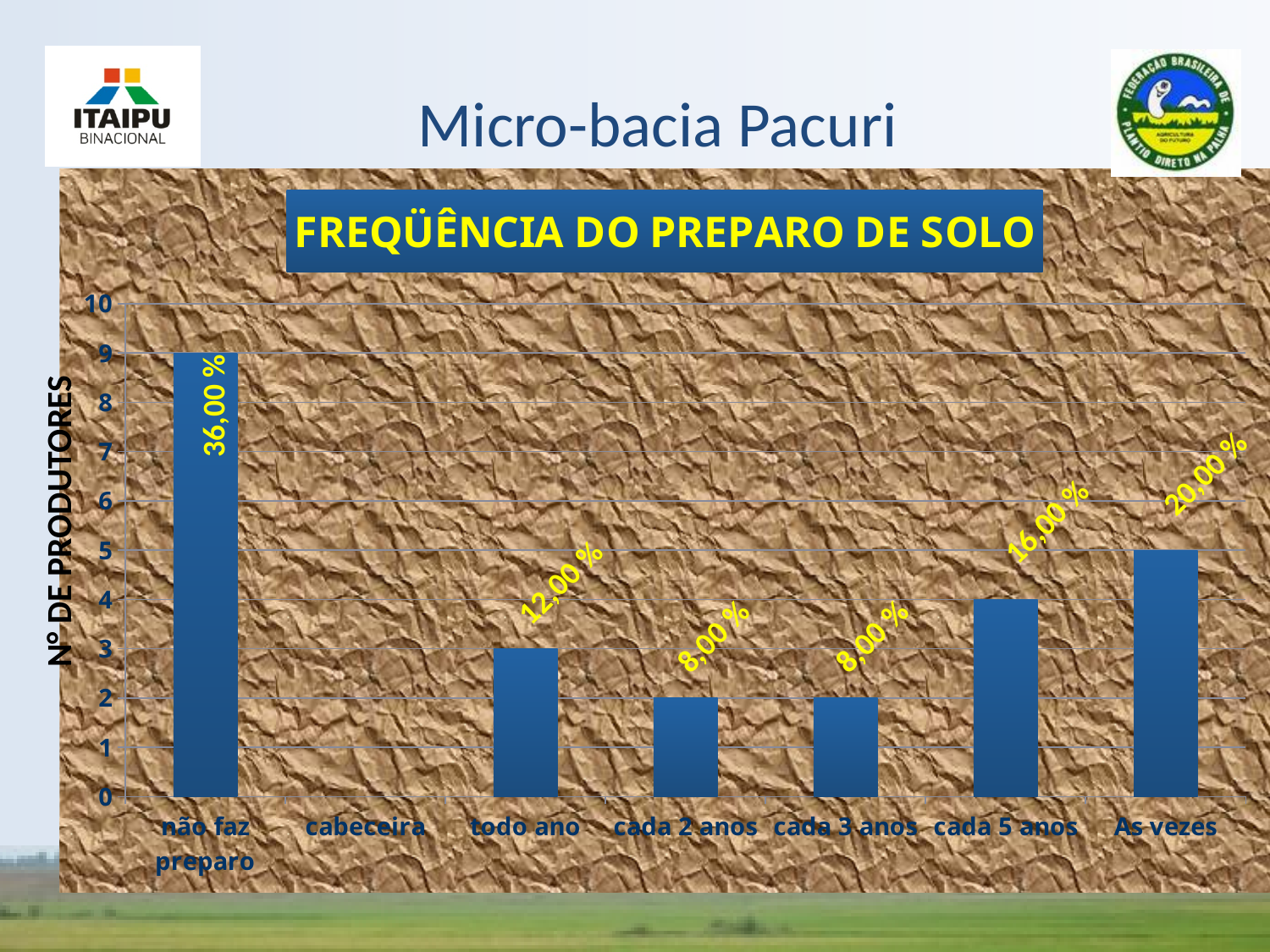
What is the difference between the percentage labels for 'não faz preparo' and 'As vezes'? 16,00 % Which has a higher value, 'cada 5 anos' or 'todo ano'? cada 5 anos Which category has the highest bar? não faz preparo How many producers does the bar for 'cada 2 anos' reach? 2 What percentage label is shown on the bar for 'As vezes'? 20,00 % What kind of chart is shown on the slide? bar chart What is the title of the chart? FREQÜÊNCIA DO PREPARO DE SOLO How many producers (Nº DE PRODUTORES) does the bar for 'todo ano' reach? 3 What percentage label is shown on the bar for 'cada 5 anos'? 16,00 % How many categories are shown on the x axis? 7 Is the value for 'não faz preparo' greater or less than 8? greater What percentage label is shown on the bar for 'não faz preparo'? 36,00 %